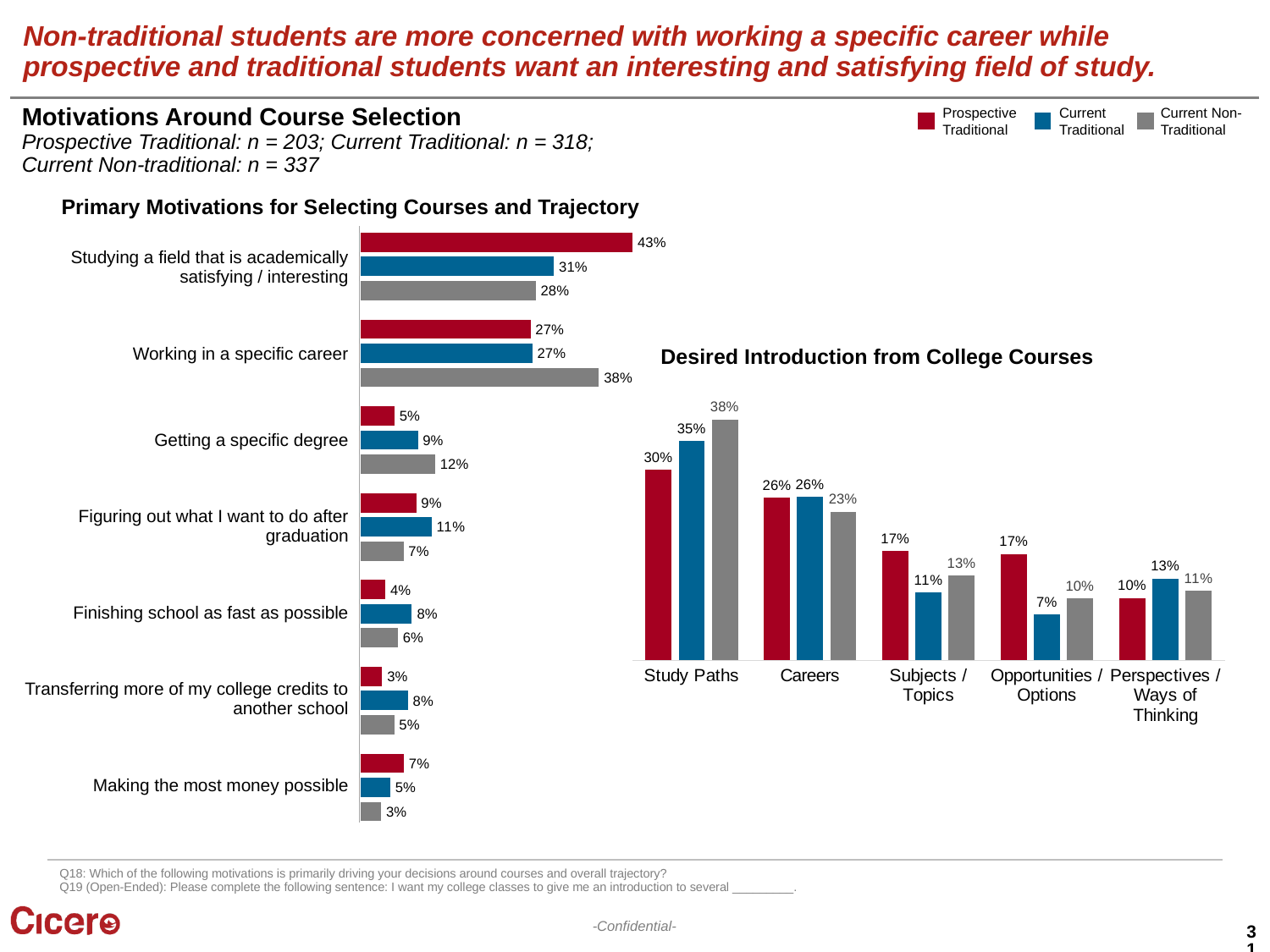
In the 'Desired Introduction from College Courses' chart, what is the difference between the Current Non-Traditional and Prospective Traditional values for 'Study Paths'? 8% In the 'Primary Motivations for Selecting Courses and Trajectory' chart, what is the value for Prospective Traditional students for 'Studying a field that is academically satisfying / interesting'? 43% In the 'Desired Introduction from College Courses' chart, which category has the lowest value for Current Traditional students? Opportunities / Options In the 'Desired Introduction from College Courses' chart, how many categories are shown on the x axis? 5 In the 'Primary Motivations for Selecting Courses and Trajectory' chart, how many categories are shown? 7 In the 'Primary Motivations for Selecting Courses and Trajectory' chart, which category has the highest value for Current Traditional students? Studying a field that is academically satisfying / interesting How many series does the legend list for the charts on this slide? 3 In the 'Primary Motivations for Selecting Courses and Trajectory' chart, what is the value for Current Non-Traditional students for 'Working in a specific career'? 38% In the 'Desired Introduction from College Courses' chart, which is larger for 'Careers': the Current Traditional value or the Current Non-Traditional value? Current Traditional In the 'Desired Introduction from College Courses' chart, what is the value for Current Traditional students for 'Study Paths'? 35% In the 'Primary Motivations for Selecting Courses and Trajectory' chart, which category has the lowest value for Current Non-Traditional students? Making the most money possible In the 'Primary Motivations for Selecting Courses and Trajectory' chart, what is the difference between the Current Non-Traditional and Prospective Traditional values for 'Getting a specific degree'? 7%